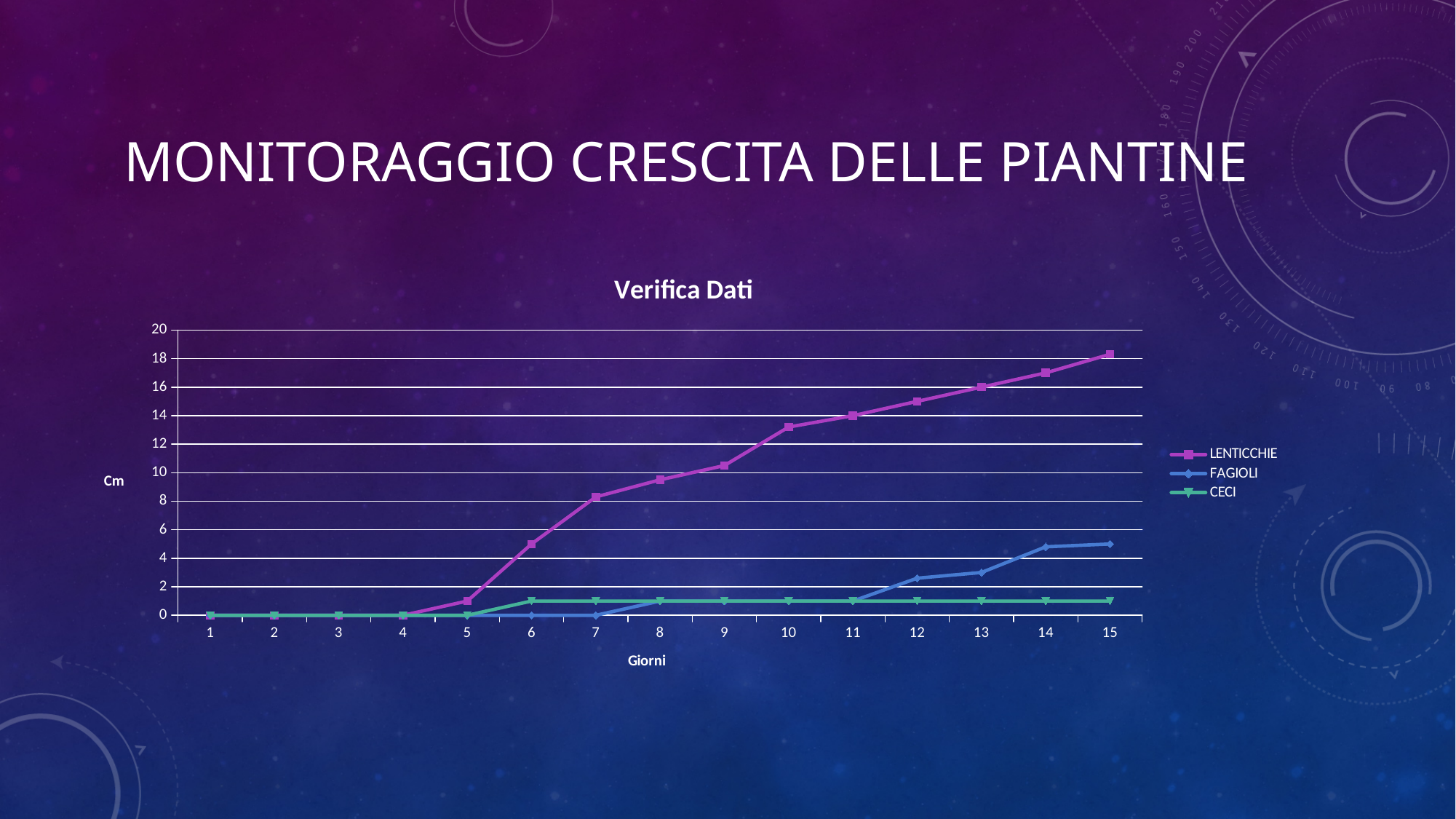
What type of chart is shown on the slide? line chart Is the value for CECI on day 10 greater or less than 2? less How many days (points) are plotted along the x axis? 15 Which series has the highest value on day 15? LENTICCHIE How many series does the legend list? 3 What is the value for LENTICCHIE on day 11? 14 What is the value for FAGIOLI on day 3? 0 On day 12, which is larger, FAGIOLI or CECI? FAGIOLI What is the title of the chart? Verifica Dati Which series has the lowest value on day 15? CECI What is the value for LENTICCHIE on day 13? 16